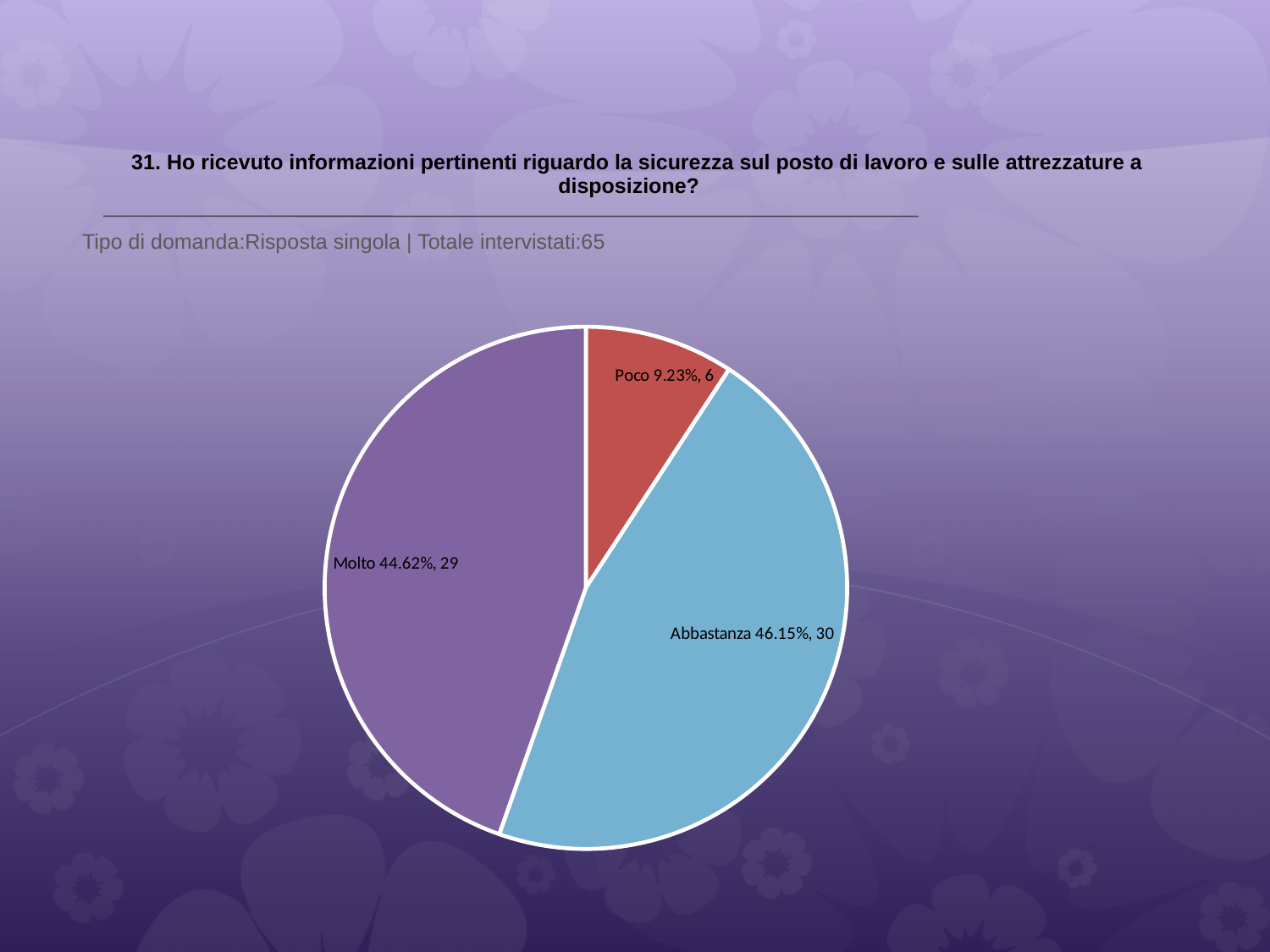
How many respondents answered Poco? 6 How many respondents answered Abbastanza? 30 Which category has the smallest slice? Poco What is the total number of respondents across all slices? 65 How many respondents answered Molto? 29 What kind of chart is shown on the slide? pie chart What percentage share does the Poco slice have? 9.23% What percentage share does the Molto slice have? 44.62% What percentage share does the Abbastanza slice have? 46.15% What is the difference in respondent count between Abbastanza and Poco? 24 How many slices does the pie chart have? 3 What colour is the Poco slice? red